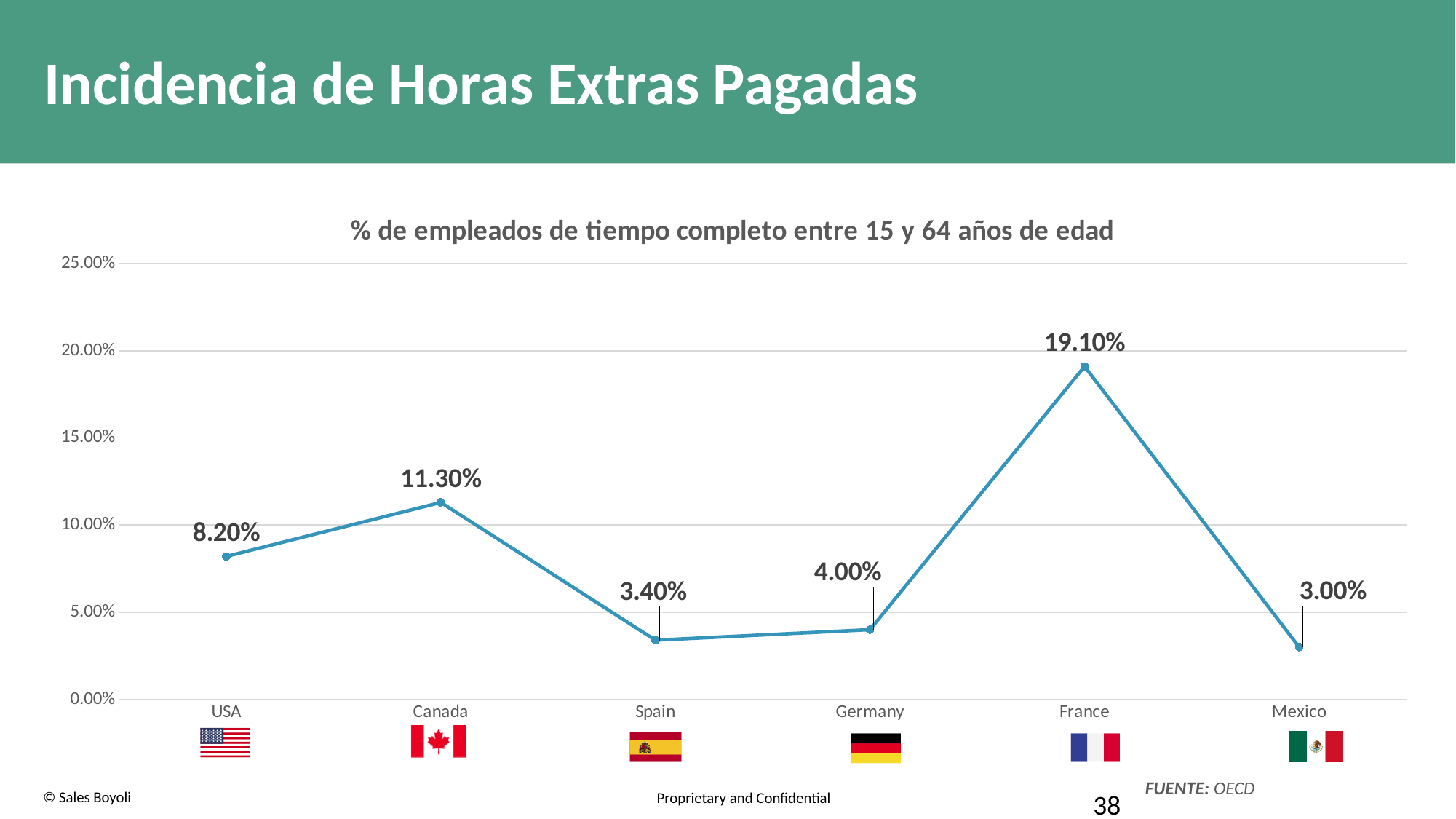
What is the value for Mexico? 3.00% What is the value for Canada? 11.30% What is the value for France? 19.10% What is the title of the chart? % de empleados de tiempo completo entre 15 y 64 años de edad What is the difference between the values for France and Canada? 7.80% What is the difference between the values for USA and Spain? 4.80% Which is larger, the value for Germany or the value for Spain? Germany Which country has the highest value? France Which country has the lowest value? Mexico How many countries are plotted on the chart? 6 What kind of chart is shown on the slide? line chart Is the value for USA greater or less than 10.00%? less